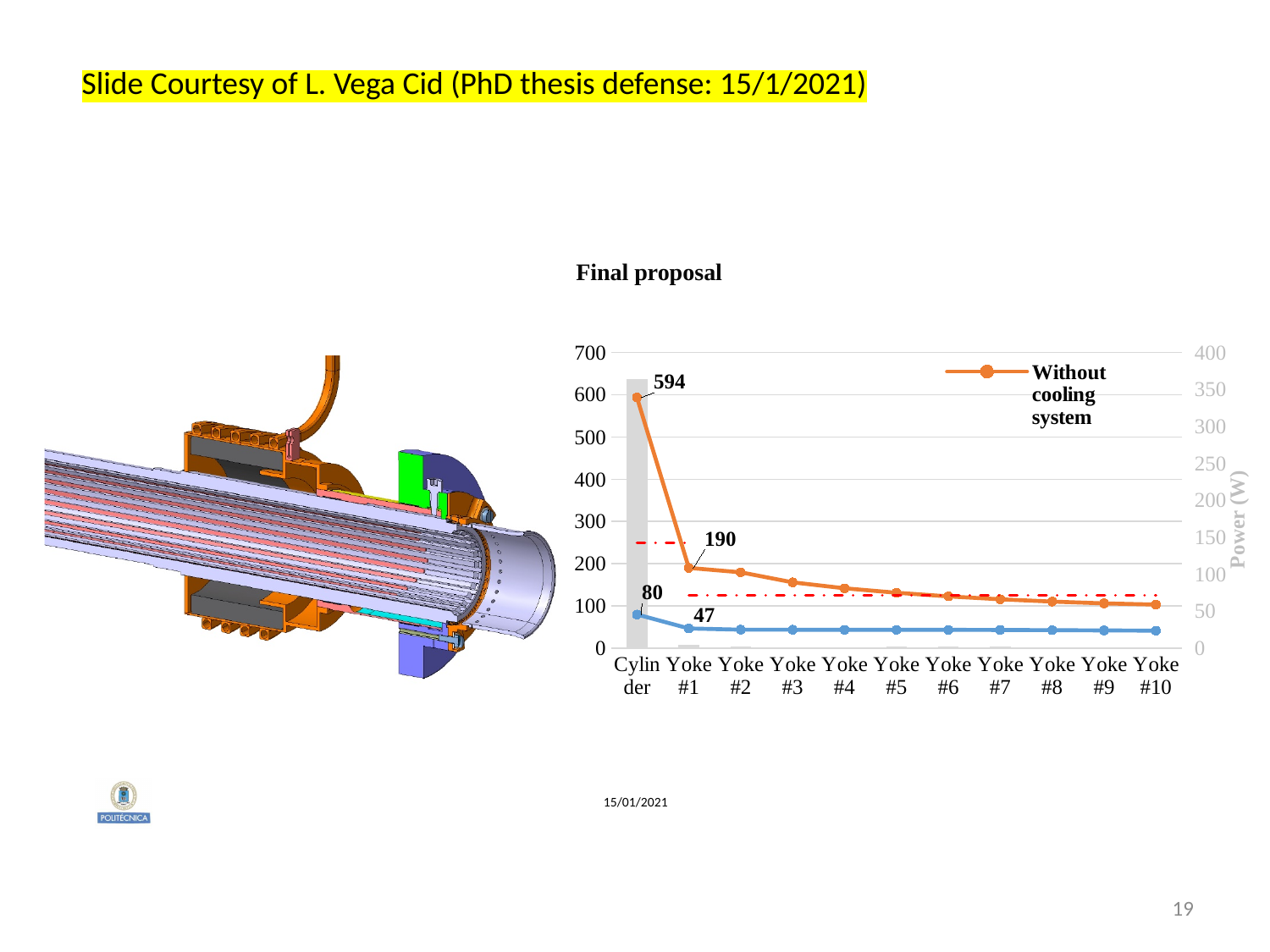
What is the value of the 'Without cooling system' series at Yoke #1? 190 At which category does the 'Without cooling system' series reach its highest value? Cylinder How many categories are shown on the x axis of the chart? 11 What is the value of the blue line at Cylinder? 80 What kind of chart is shown on the slide? Combination bar and line chart What is the value of the blue line at Yoke #1? 47 What is the difference between the 'Without cooling system' values at Cylinder and Yoke #1? 404 What is the title of the right-hand vertical axis of the chart? Power (W) On the left axis, is the 'Without cooling system' value at Yoke #10 greater or less than 200? less Does the 'Without cooling system' series rise or fall from Cylinder to Yoke #10? Fall At Cylinder, how much higher is the 'Without cooling system' value than the blue line value? 514 What is the value of the 'Without cooling system' series at Cylinder? 594